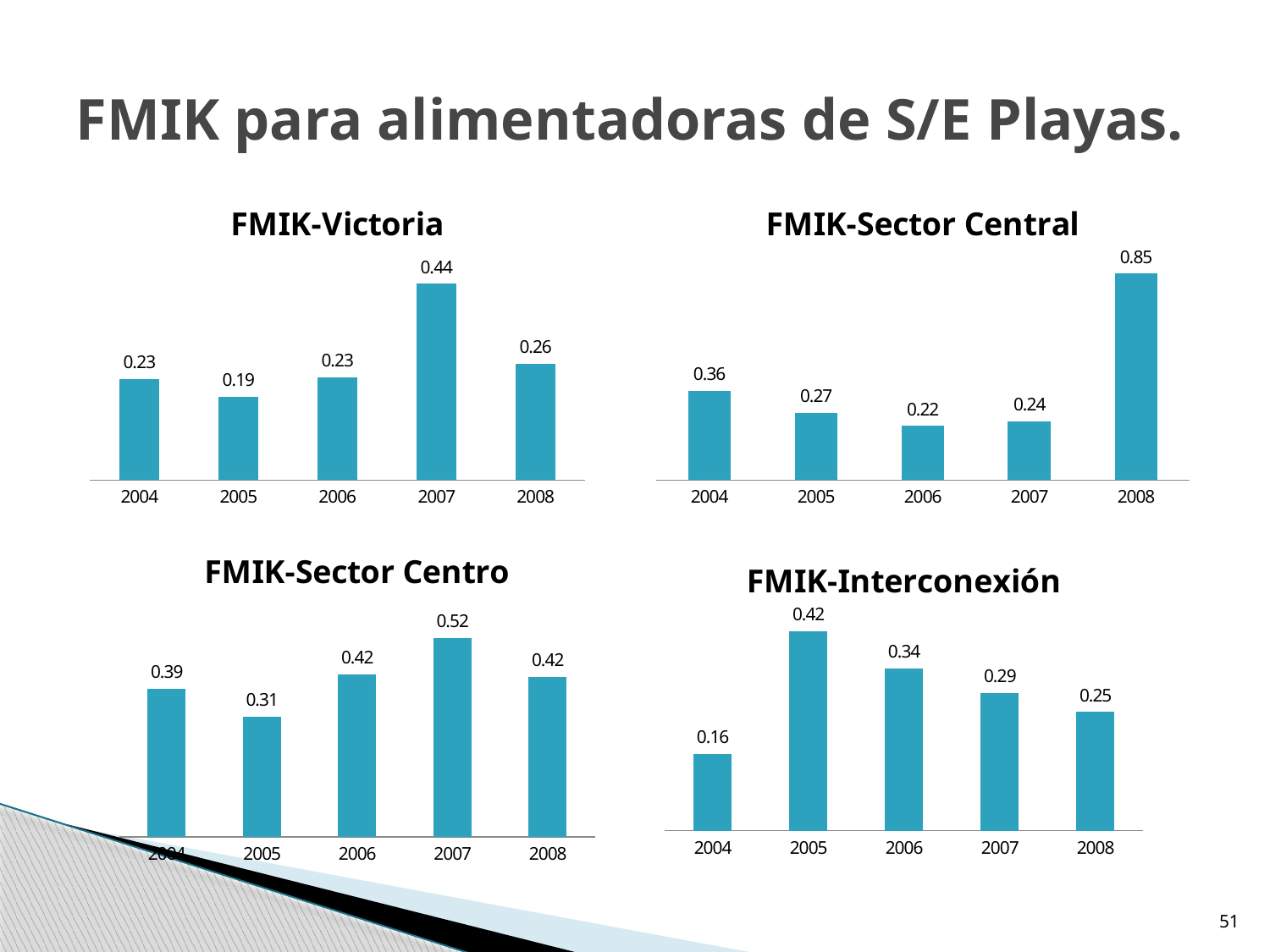
In the FMIK-Interconexión chart, which is larger, the value for 2006 or the value for 2007? 2006 In the FMIK-Sector Central chart, what is the difference between the values for 2008 and 2004? 0.48 In the FMIK-Interconexión chart, do the values rise or fall from 2005 to 2008? fall In the FMIK-Victoria chart, what is the value for 2007? 0.44 In the FMIK-Sector Central chart, which year has the lowest value? 2006 How many years are shown on the x axis of the FMIK-Victoria chart? 5 In the FMIK-Sector Centro chart, which year has the highest value? 2007 What kind of chart is the FMIK-Sector Central chart? bar chart In the FMIK-Sector Centro chart, what is the value for 2005? 0.31 In the FMIK-Interconexión chart, what is the value for 2004? 0.16 In the FMIK-Victoria chart, which year has the lowest value? 2005 In the FMIK-Sector Central chart, what is the value for 2008? 0.85